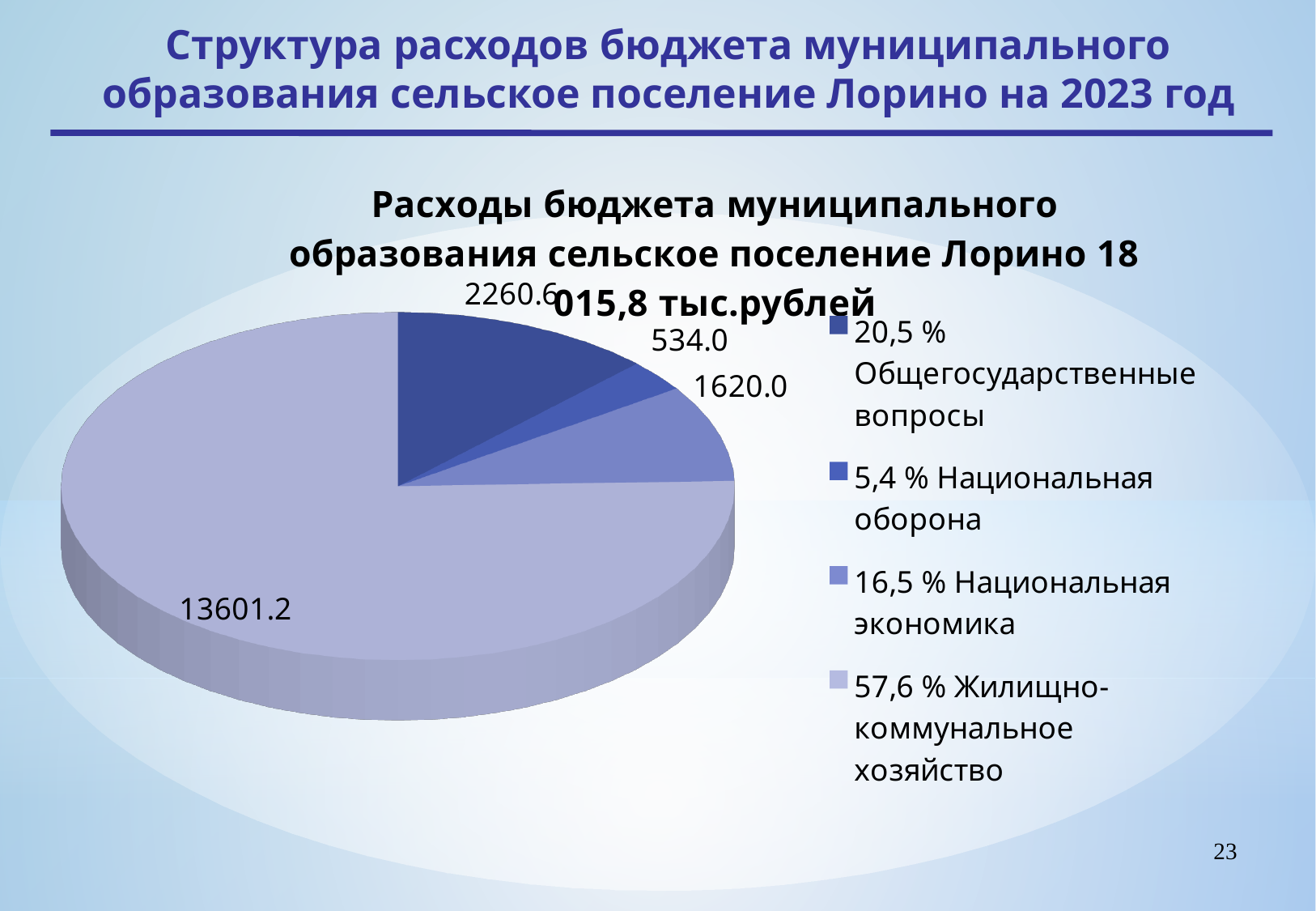
What is the value for Общегосударственные вопросы? 2260.6 What is the difference between the values for Общегосударственные вопросы and Национальная оборона? 1726.6 What is the value for Национальная экономика? 1620.0 How many entries does the legend list? 4 What kind of chart is shown on the slide? Pie chart What share of the pie does Национальная экономика represent, according to the legend? 16,5 % Which is larger, the value for Национальная экономика or the value for Общегосударственные вопросы? Общегосударственные вопросы Which category has the smallest slice of the pie? Национальная оборона What is the value for Жилищно-коммунальное хозяйство? 13601.2 Which category has the largest slice of the pie? Жилищно-коммунальное хозяйство How many slices does the pie chart have? 4 What is the value for Национальная оборона? 534.0